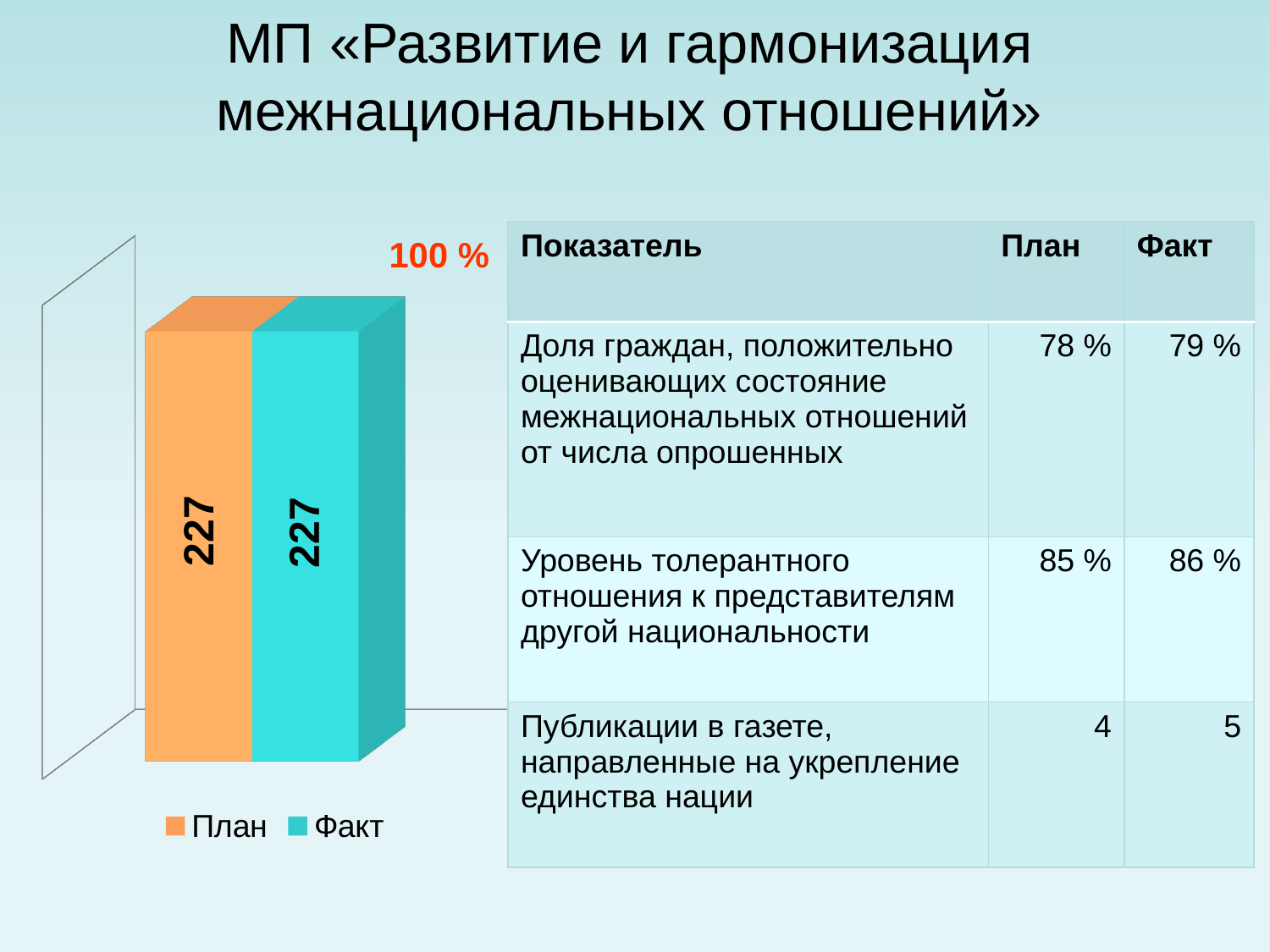
What is the value of the Факт bar in the chart? 227 How many bars are plotted in the chart? 2 Which series in the chart is shown in orange? План Are the План and Факт values in the chart equal? Yes What kind of chart is shown on the slide? bar chart How many series does the chart legend list? 2 What is the value of the План bar in the chart? 227 Is the value of the Факт bar greater or less than 100? greater Which series in the chart is shown in turquoise? Факт What is the difference between the План and Факт values in the chart? 0